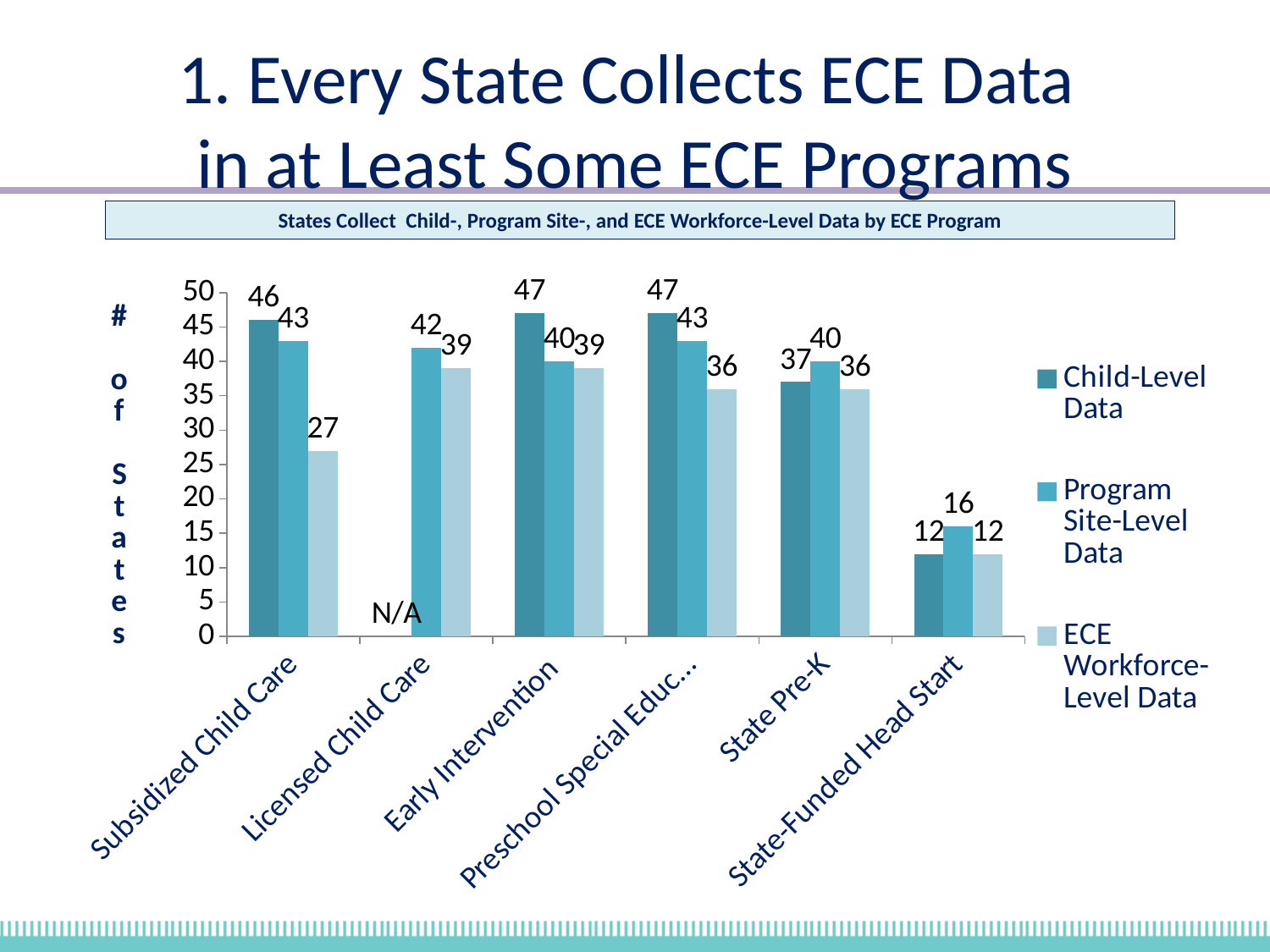
Which ECE program has the lowest value for Child-Level Data? State-Funded Head Start For State Pre-K, which is larger: Child-Level Data or Program Site-Level Data? Program Site-Level Data How many ECE programs are shown on the x axis? 6 How many states collect Child-Level Data for Subsidized Child Care? 46 What is shown in place of the Child-Level Data bar for Licensed Child Care? N/A Which ECE program has the lowest value for ECE Workforce-Level Data? State-Funded Head Start What is the value for Program Site-Level Data for State Pre-K? 40 What is the value for ECE Workforce-Level Data for Subsidized Child Care? 27 What is the difference between the Child-Level Data and ECE Workforce-Level Data values for Subsidized Child Care? 19 What is the value for Program Site-Level Data for State-Funded Head Start? 16 What kind of chart is shown on the slide? Bar chart How many data series does the legend list? 3